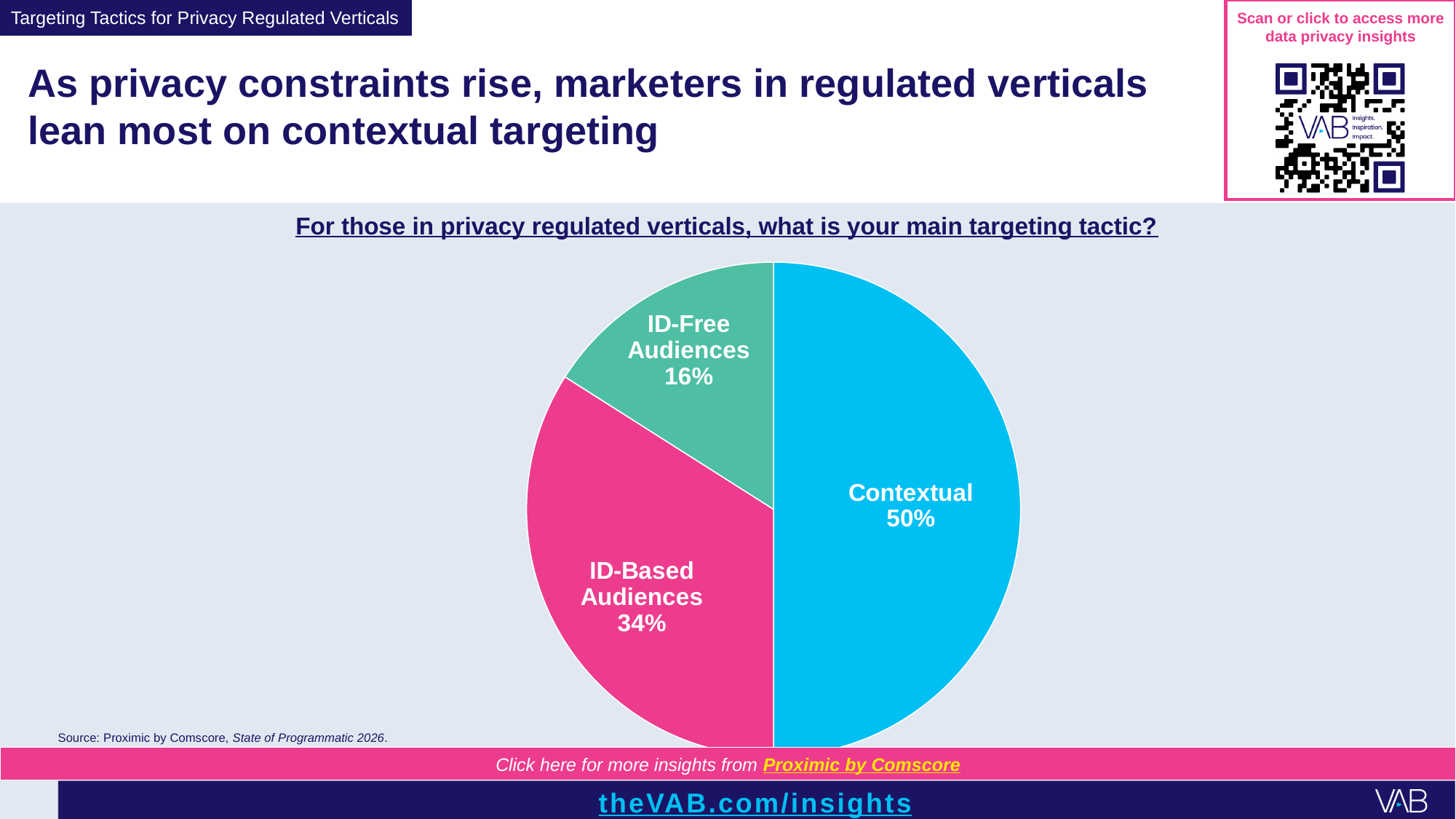
What share of respondents chose ID-Based Audiences as their main targeting tactic? 34% Which targeting tactic has the smallest slice of the pie? ID-Free Audiences Which is larger, the share for ID-Based Audiences or the share for ID-Free Audiences? ID-Based Audiences What is the difference in percentage points between Contextual and ID-Based Audiences? 16 What share of respondents chose ID-Free Audiences as their main targeting tactic? 16% Which targeting tactic has the largest slice of the pie? Contextual What colour is the Contextual slice of the pie? blue What share of respondents chose Contextual as their main targeting tactic? 50% How many slices does the pie chart have? 3 What question does the chart title say respondents were asked? For those in privacy regulated verticals, what is your main targeting tactic? What kind of chart is shown on the slide? pie chart What is the difference in percentage points between ID-Based Audiences and ID-Free Audiences? 18